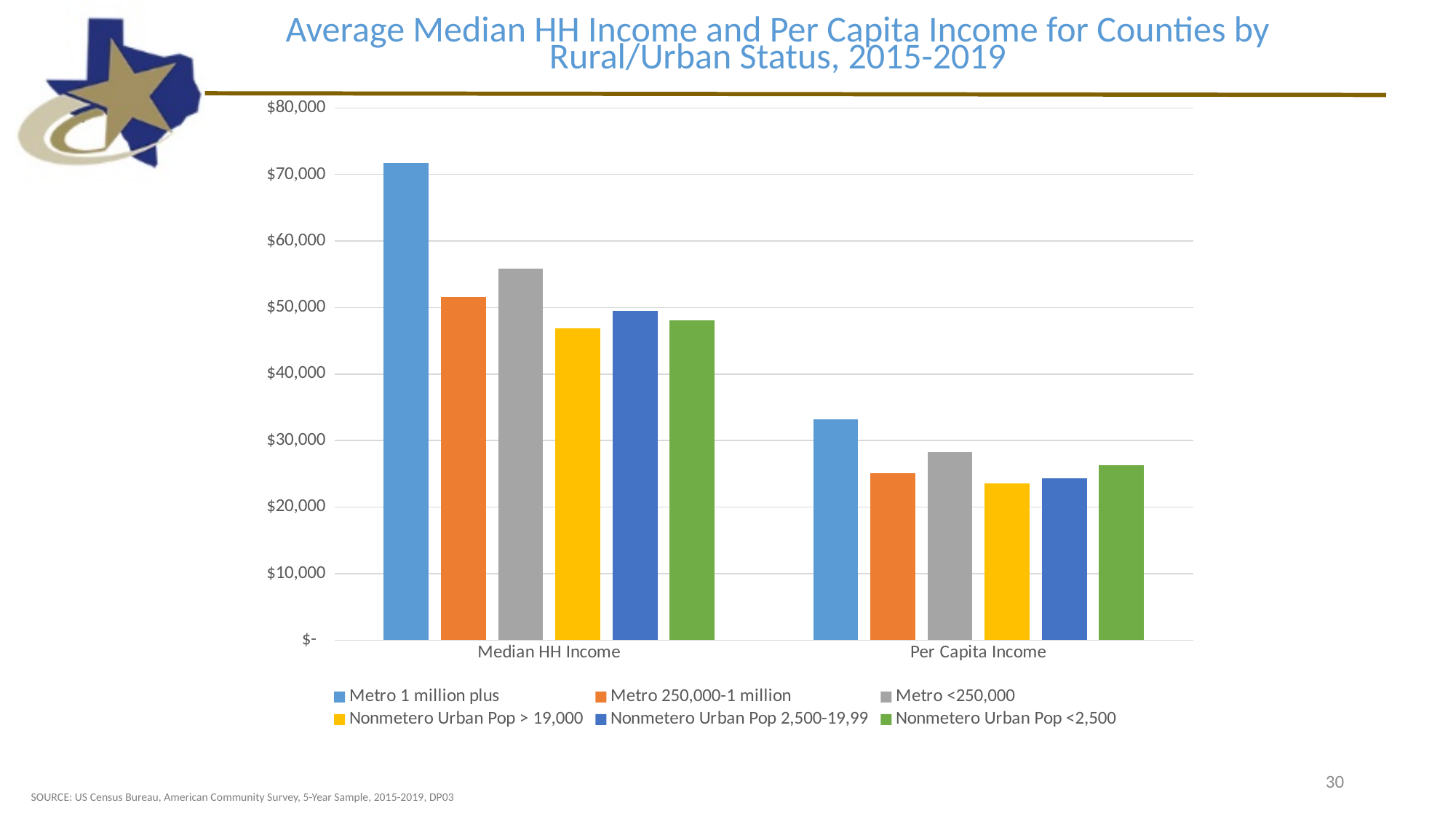
How many series does the legend list? 6 What is the title of the chart? Average Median HH Income and Per Capita Income for Counties by Rural/Urban Status, 2015-2019 Is the Per Capita Income for Metro 1 million plus greater or less than $30,000? greater Which series has the highest Per Capita Income? Metro 1 million plus How many categories are shown on the x axis? 2 Is the Median HH Income for Nonmetero Urban Pop > 19,000 greater or less than $50,000? less Is the Median HH Income for Metro 1 million plus greater or less than $70,000? greater What kind of chart is shown on the slide? Bar chart For Per Capita Income, which is larger: Metro <250,000 or Nonmetero Urban Pop <2,500? Metro <250,000 For Median HH Income, which is larger: Metro <250,000 or Metro 250,000-1 million? Metro <250,000 Which series has the highest Median HH Income? Metro 1 million plus